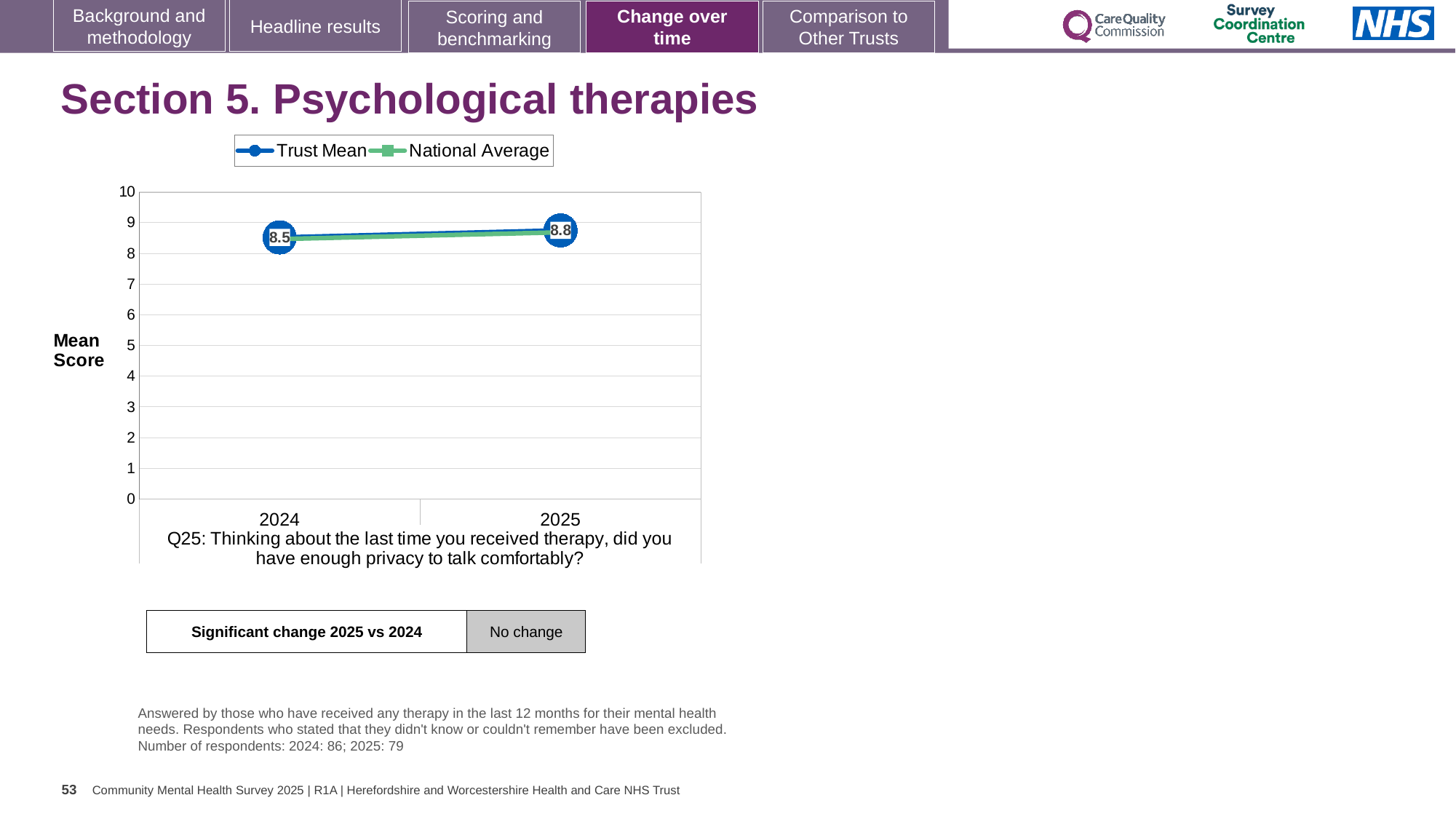
What is the label on the y axis of the chart? Mean Score What is the Trust Mean score for 2025? 8.8 What kind of chart is shown on the slide? line chart Does the Trust Mean rise or fall from 2024 to 2025? rise How many series does the legend list? 2 What is the Trust Mean score for 2024? 8.5 Is the Trust Mean value for 2025 greater or less than 9? less How many years are plotted on the x axis? 2 Is the National Average value for 2024 greater or less than 5? greater Which year has the higher Trust Mean score? 2025 Is the Trust Mean for 2025 larger or smaller than the Trust Mean for 2024? larger By how much did the Trust Mean change from 2024 to 2025? 0.3